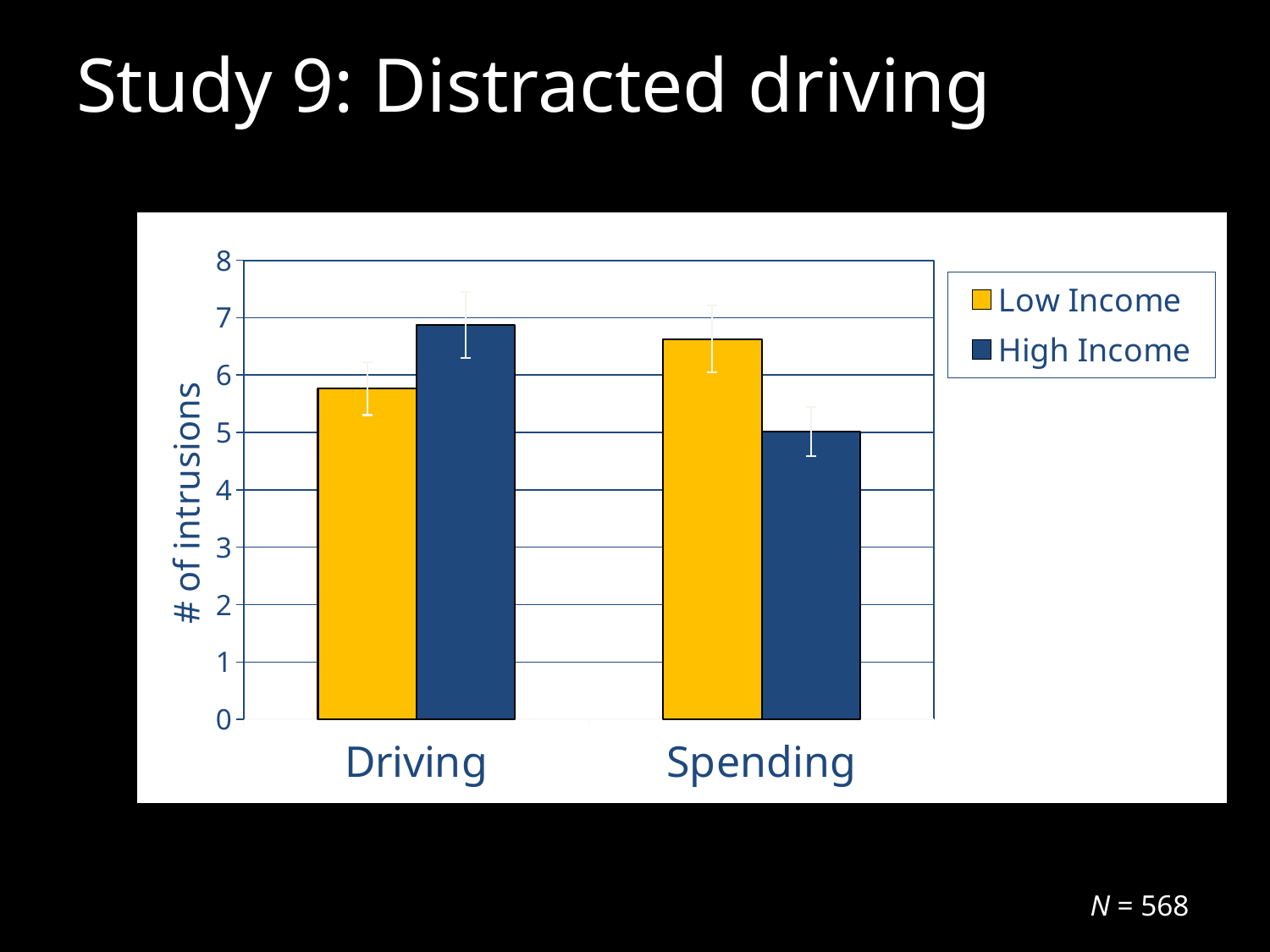
Which bar is the lowest in the chart? High Income for Spending Is the Low Income value for Spending greater or less than 6? greater Is the High Income value for Spending greater or less than 6? less What kind of chart is shown on the slide? Bar chart Is the High Income value for Driving greater or less than 6? greater How many series does the legend list? 2 For Spending, which is larger: Low Income or High Income? Low Income For Driving, which is larger: Low Income or High Income? High Income Which series is shown in yellow in the legend? Low Income How many categories are shown on the x axis? 2 What is the label of the y axis? # of intrusions